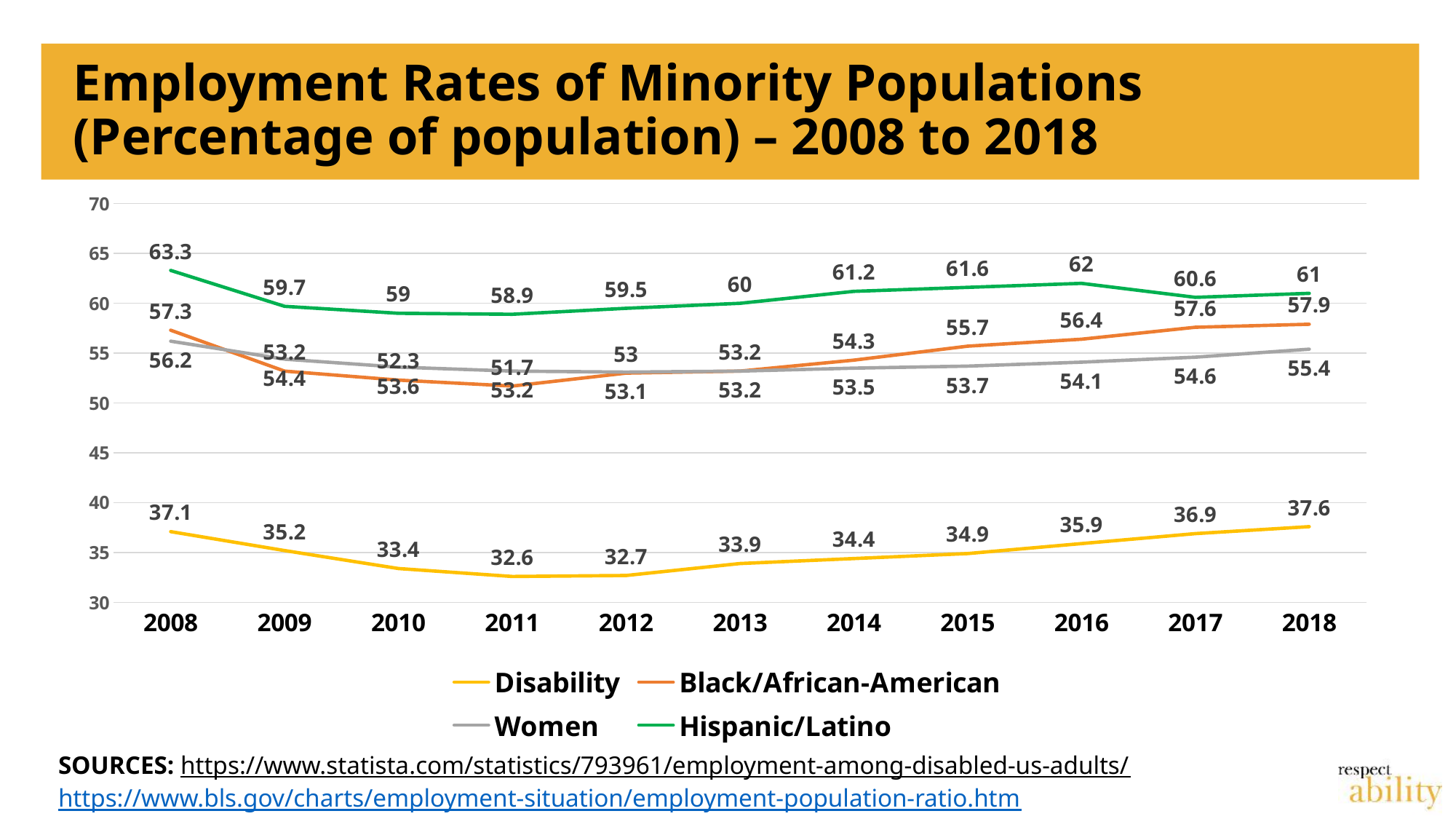
How many series does the legend list? 4 What is the Disability employment rate in 2011? 32.6 What is the Hispanic/Latino employment rate in 2008? 63.3 Does the Disability employment rate rise or fall from 2011 to 2018? Rise What is the Women employment rate in 2018? 55.4 What is the Black/African-American employment rate in 2018? 57.9 What is the difference between the Hispanic/Latino rate and the Disability rate in 2018? 23.4 How many years are plotted along the x axis? 11 What kind of chart is shown on the slide? Line chart In which year is the Hispanic/Latino employment rate highest? 2008 Which series has the higher value in 2016, Black/African-American or Women? Black/African-American In which year is the Disability employment rate lowest? 2011